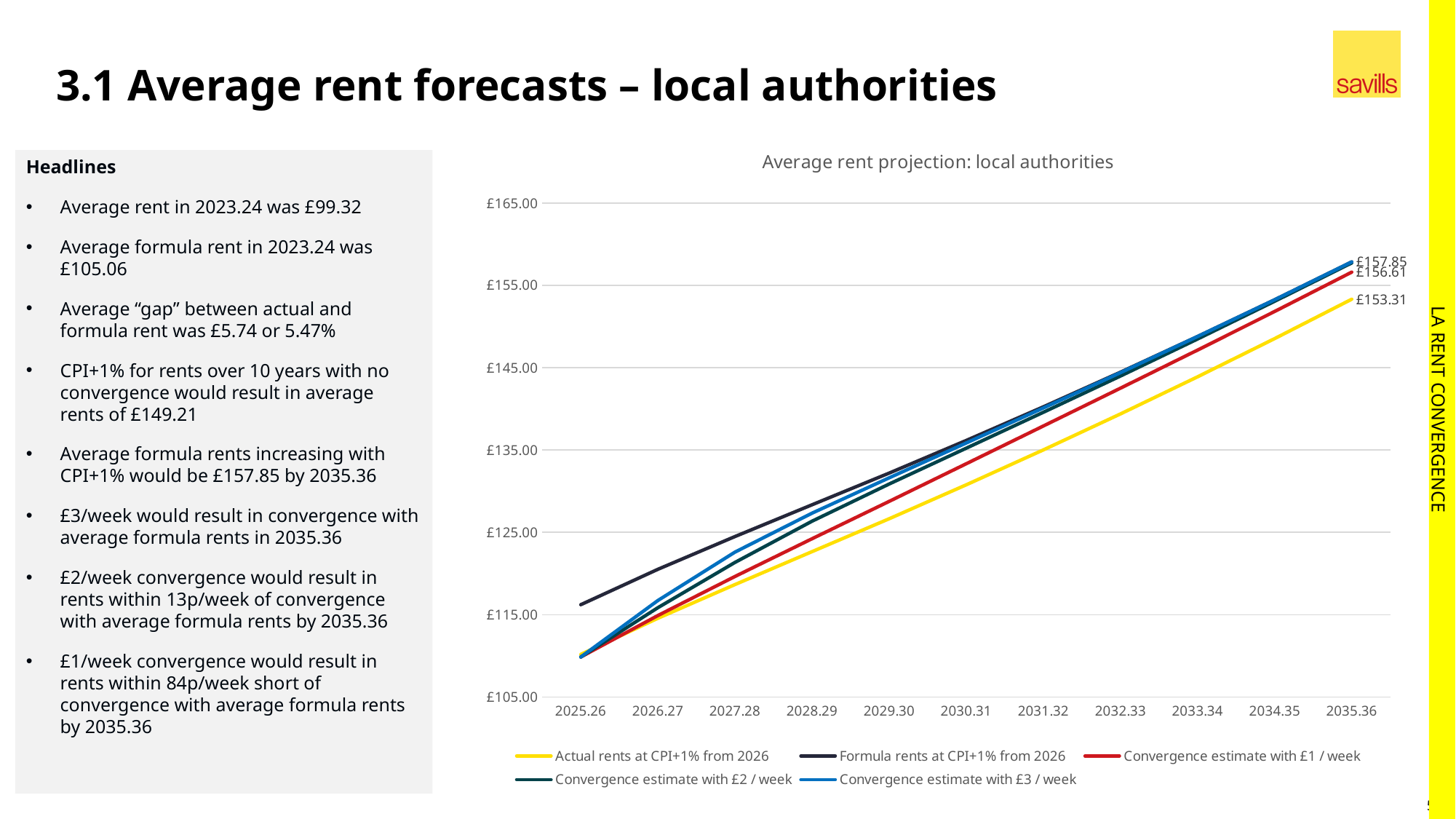
What is the title of the chart? Average rent projection: local authorities Do the values of the series rise or fall from 2025.26 to 2035.36? rise Is the value for 'Actual rents at CPI+1% from 2026' in 2025.26 greater or less than £115.00? less In 2027.28, which is higher: 'Formula rents at CPI+1% from 2026' or 'Actual rents at CPI+1% from 2026'? Formula rents at CPI+1% from 2026 Is the value for 'Actual rents at CPI+1% from 2026' in 2030.31 greater or less than £135.00? less How many series does the legend of the chart list? 5 What is the difference between 'Formula rents at CPI+1% from 2026' and 'Actual rents at CPI+1% from 2026' in 2035.36? £4.54 What is the value of 'Actual rents at CPI+1% from 2026' in 2035.36? £153.31 What kind of chart is shown on the slide? line chart What is the value of 'Formula rents at CPI+1% from 2026' in 2035.36? £157.85 Which series has the lowest value in 2035.36? Actual rents at CPI+1% from 2026 How many years are shown along the x axis of the chart? 11